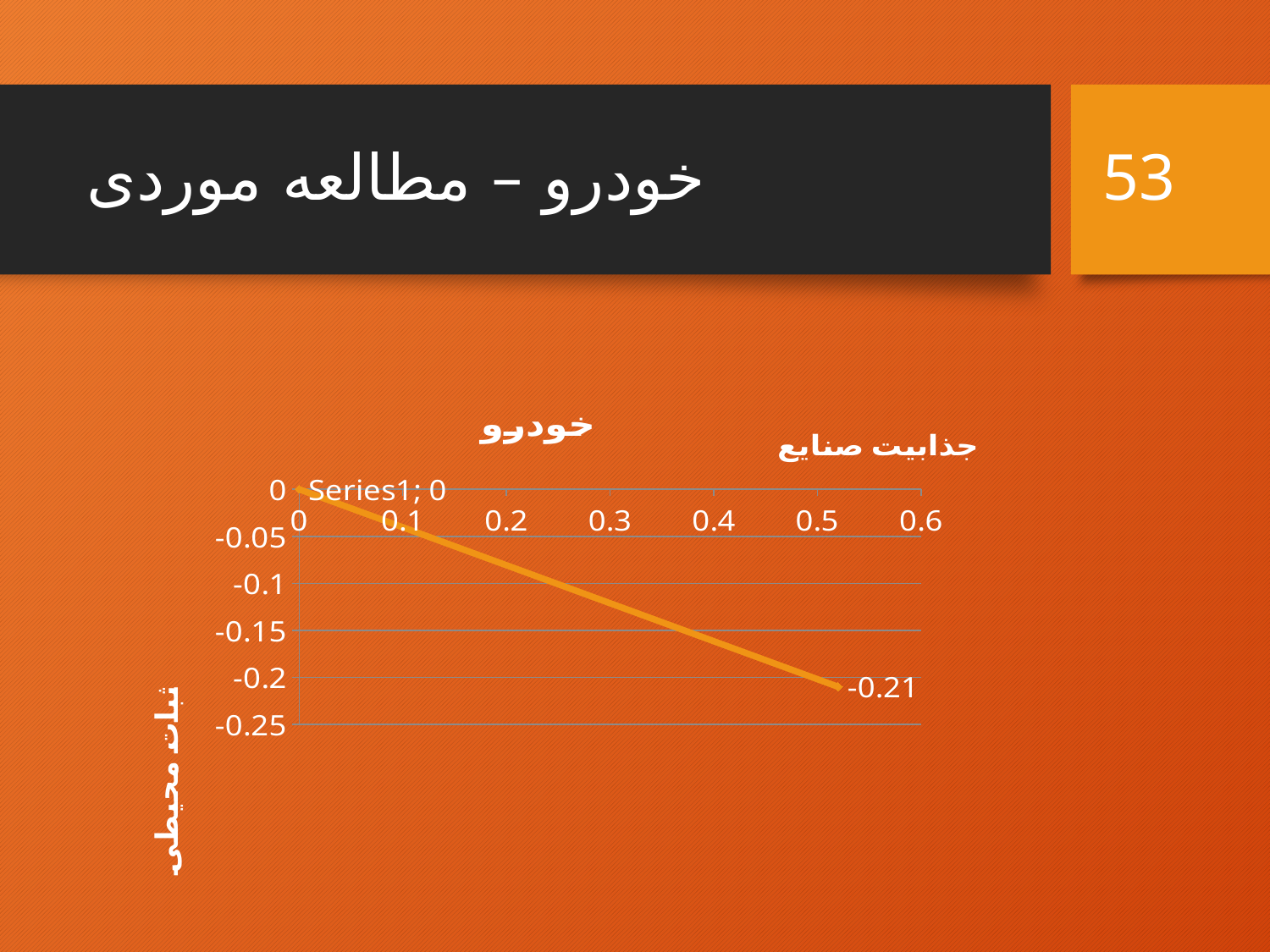
What is the value shown by the data label at the left end of the line (Series1)? 0 What is the value shown by the data label at the right end of the line? -0.21 Is the x-axis position of the right end of the line greater or less than 0.5? greater How many data points are plotted on the line? 2 What is the lowest value plotted on the line? -0.21 What is the title of the chart? خودرو What is the difference between the starting value (0) and the ending value (-0.21) of the line? 0.21 What is the highest value plotted on the line? 0 Does the line rise or fall as it moves from left to right along the x axis? fall Which is larger, the value at the left end of the line or the value at the right end? the left end (0) What kind of chart is shown on the slide? line chart What is the label on the horizontal axis of the chart? جذابیت صنایع